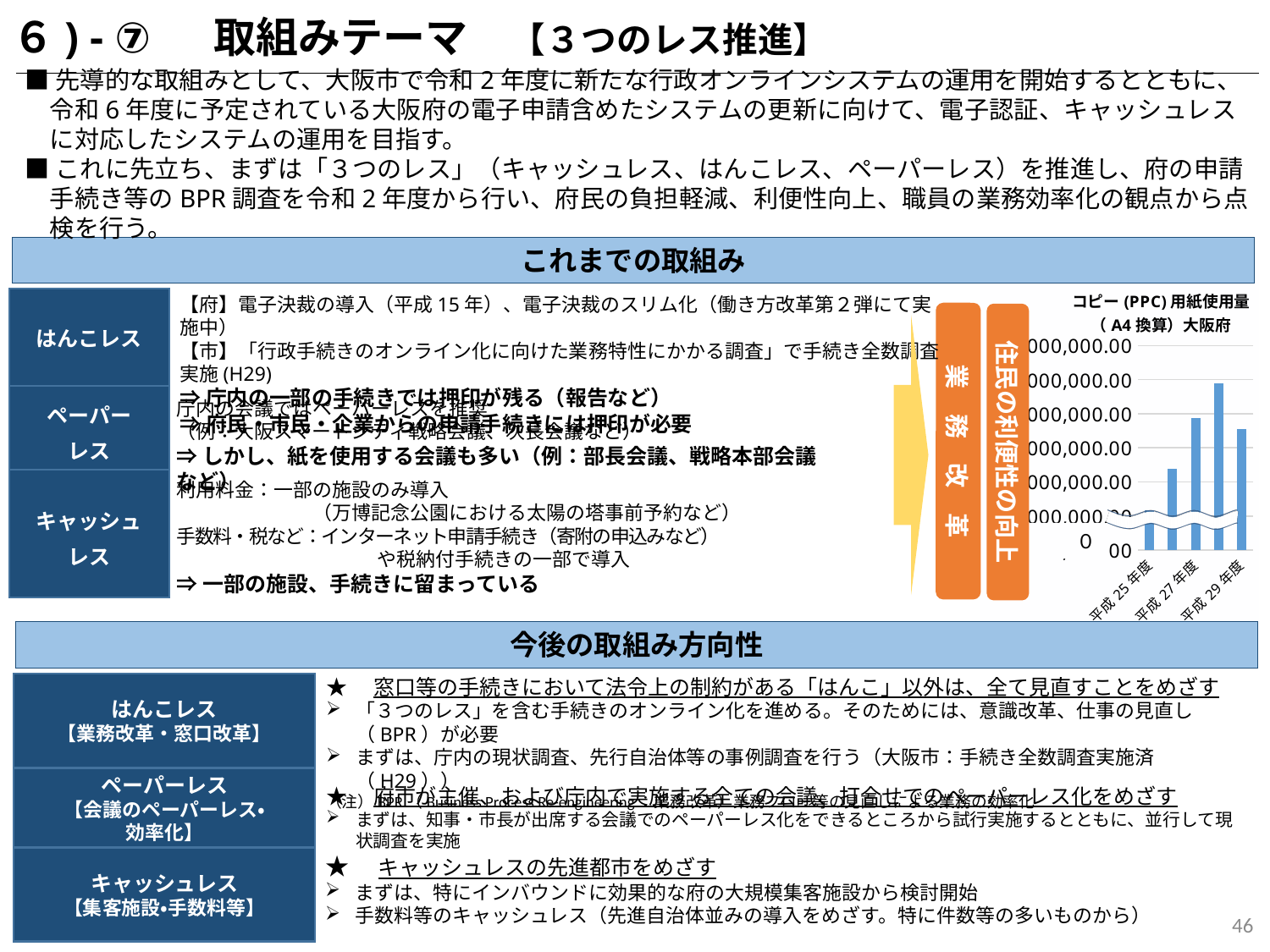
How many bars are plotted in the chart on the right side of the slide? 5 What kind of chart is shown on the right side of the slide? bar chart In the chart on the right side of the slide, which is larger, the value for 平成25年度 or the value for 平成29年度? 平成29年度 In the chart on the right side of the slide, which is larger, the value for 平成27年度 or the value for 平成29年度? 平成27年度 In the chart on the right side of the slide, do the values generally rise or fall from 平成25年度 to 平成29年度? rise What is the title of the chart on the right side of the slide? コピー(PPC)用紙使用量（A4換算）大阪府 Which fiscal year is the first category on the x axis of the chart on the right side of the slide? 平成25年度